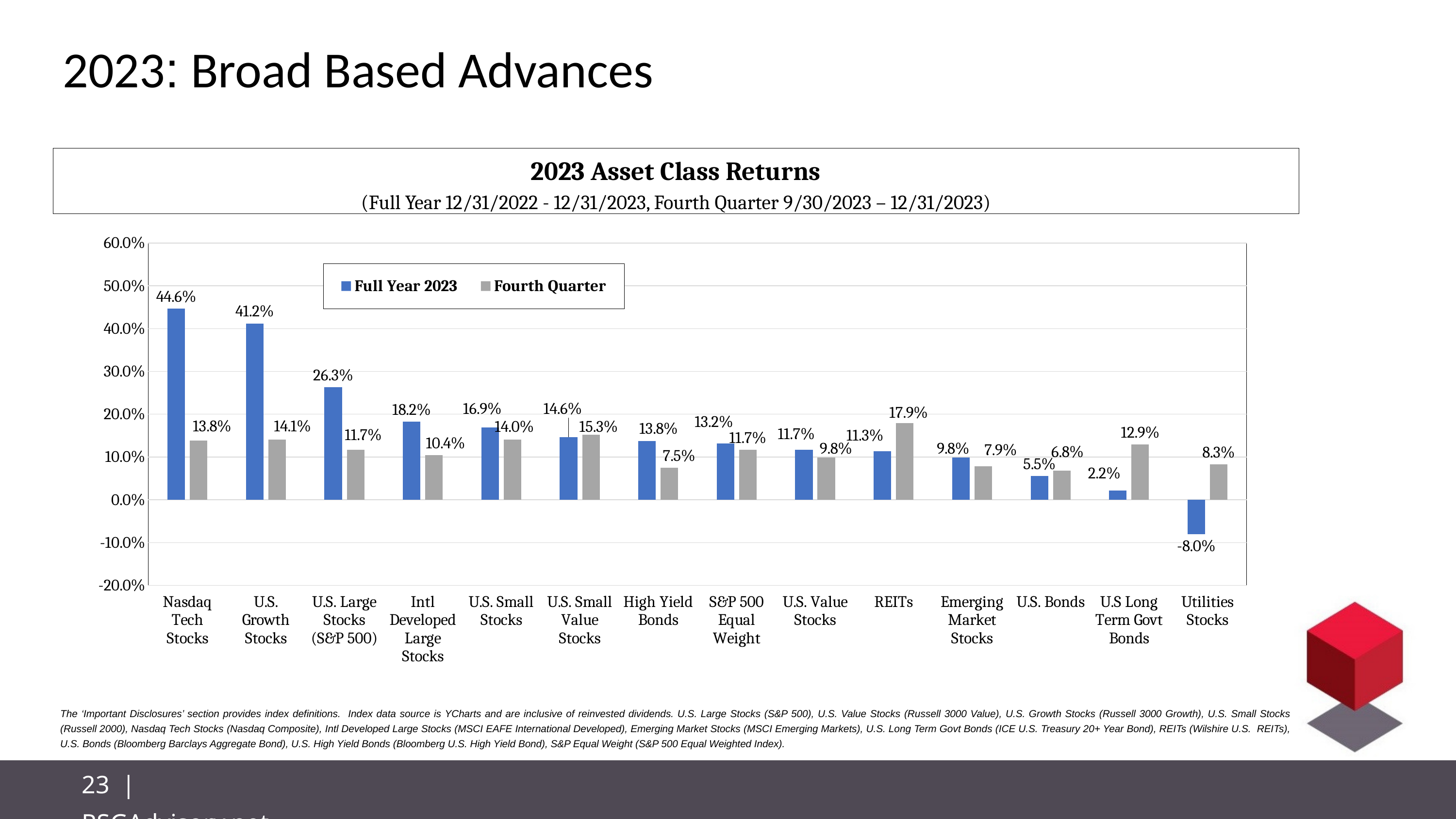
What is the Fourth Quarter return for U.S Long Term Govt Bonds? 12.9% What is the Fourth Quarter return for REITs? 17.9% What kind of chart is shown on the slide? Bar chart Which asset class has the lowest Full Year 2023 return? Utilities Stocks How many asset classes are shown on the x axis? 14 What is the difference between the Full Year 2023 return and the Fourth Quarter return for U.S. Growth Stocks? 27.1% What is the Full Year 2023 return for U.S. Large Stocks (S&P 500)? 26.3% What colour represents the Fourth Quarter series? Gray What is the Full Year 2023 return for Nasdaq Tech Stocks? 44.6% Which is larger for U.S. Small Value Stocks: the Full Year 2023 return or the Fourth Quarter return? Fourth Quarter How many series does the legend list? 2 Which asset class has the highest Fourth Quarter return? REITs